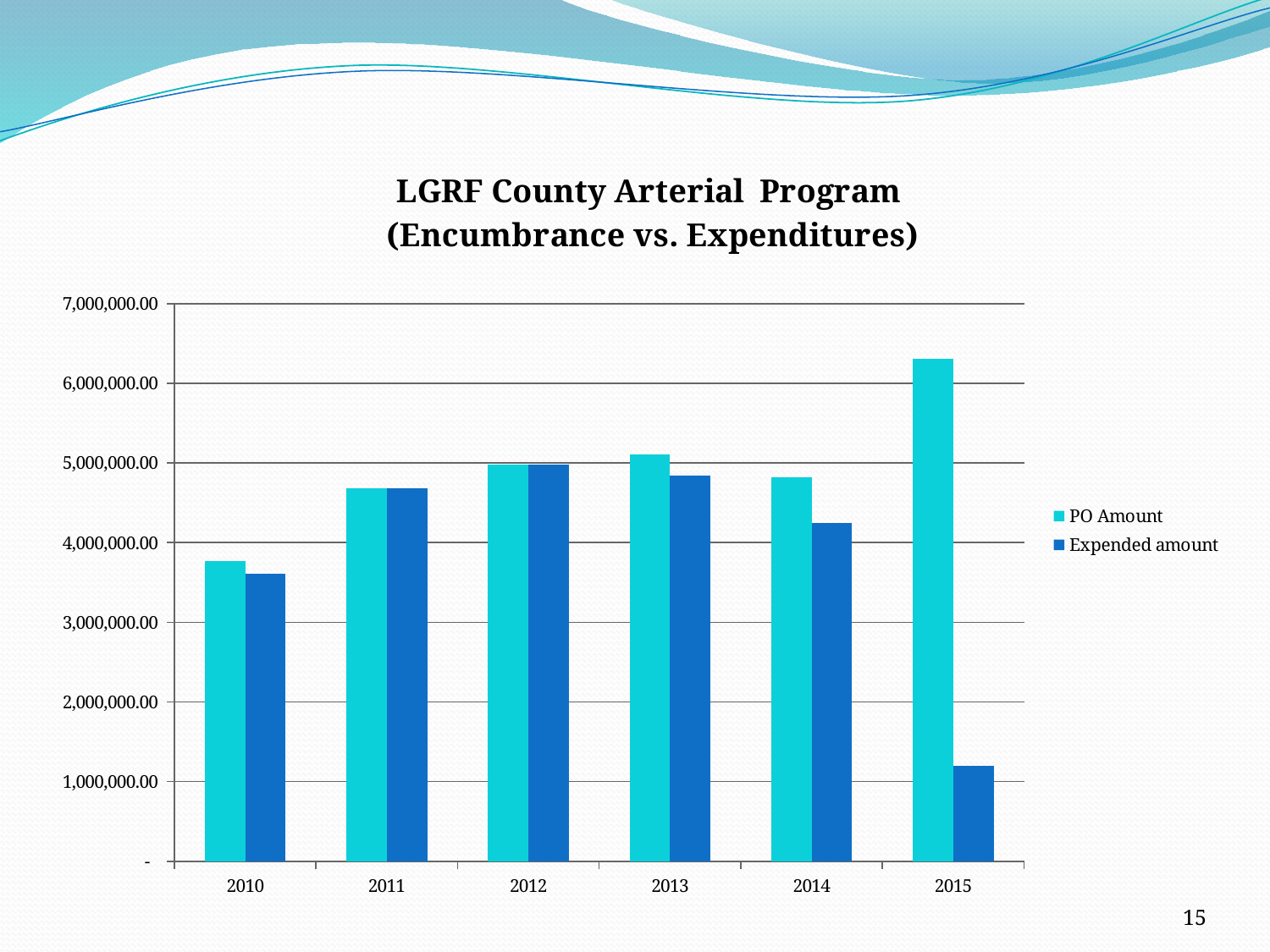
Is the PO Amount for 2015 greater or less than 6,000,000.00? greater Which series is shown in dark blue in the legend? Expended amount In 2014, which is larger, the PO Amount or the Expended amount? PO Amount Is the PO Amount for 2010 greater or less than 4,000,000.00? less Which year has the lowest PO Amount? 2010 Is the Expended amount for 2015 greater or less than 1,000,000.00? greater How many series does the legend list? 2 How many years are shown on the x axis? 6 Which year has the lowest Expended amount? 2015 What kind of chart is shown on the slide? bar chart Which year has the highest PO Amount? 2015 Does the PO Amount rise or fall from 2010 to 2013? rise